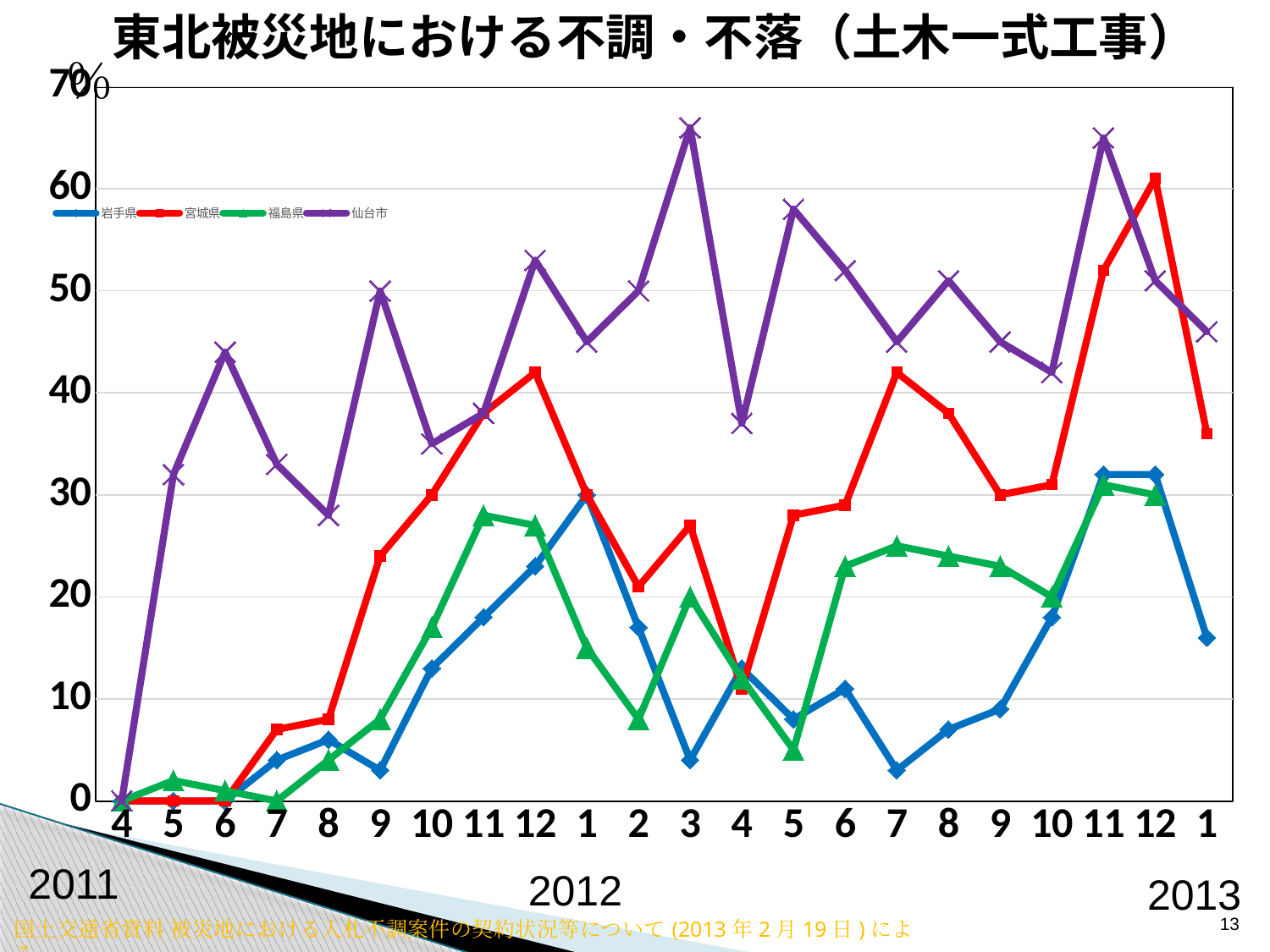
Is the value for 仙台市 in March 2012 greater or less than 60? greater In March 2012, which is larger, the value for 仙台市 or the value for 宮城県? 仙台市 Does the value for 岩手県 rise or fall from December 2012 to January 2013? fall Which series has the lowest value in July 2012? 岩手県 What kind of chart is shown on the slide? line chart Is the value for 福島県 in November 2011 greater or less than 20? greater Which series reaches the highest value anywhere on the chart? 仙台市 Which series has the highest value in September 2012? 仙台市 How many monthly points are plotted along the x axis? 22 Is the value for 岩手県 in January 2013 greater or less than 20? less How many series does the legend list? 4